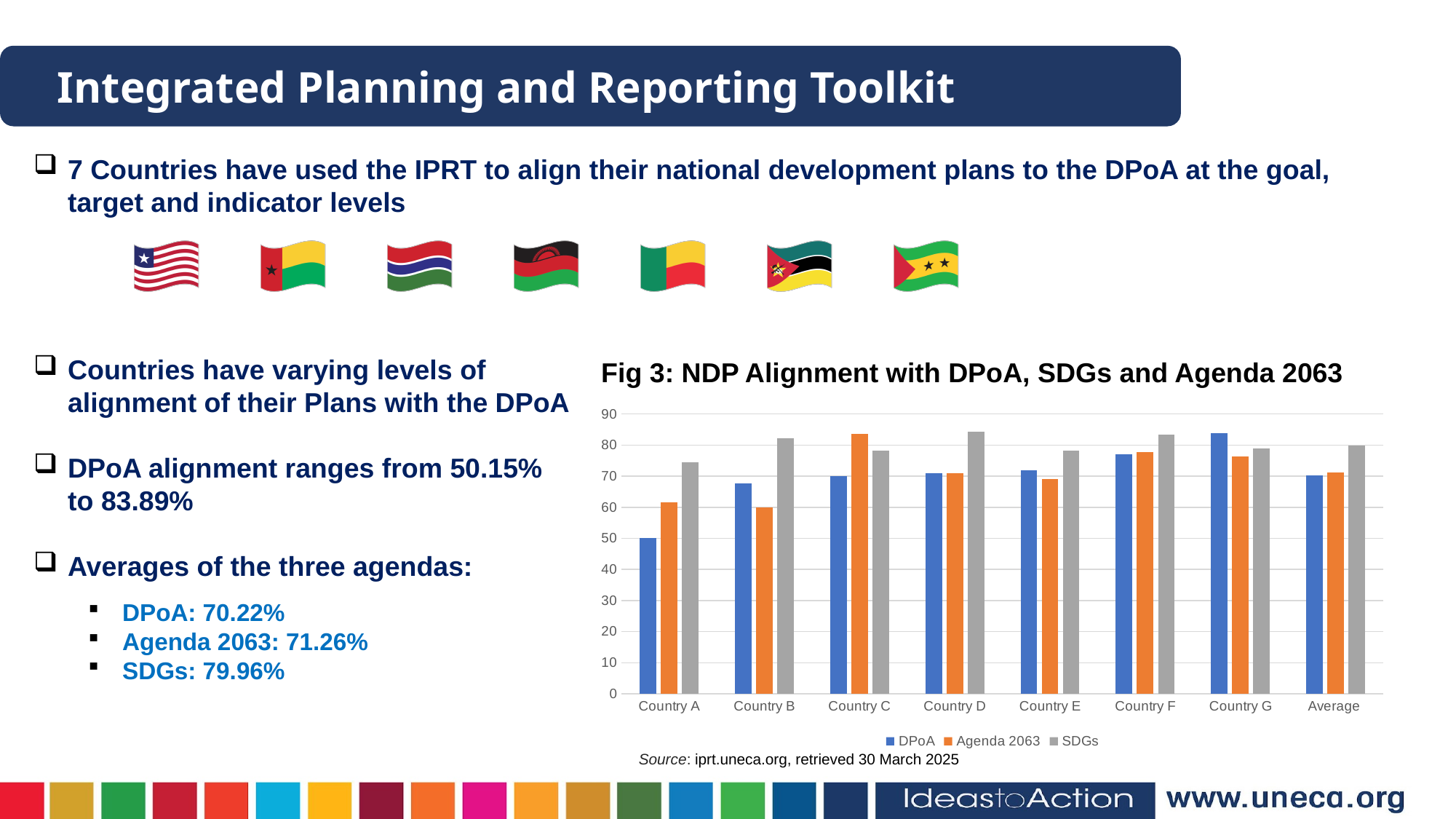
Is the SDGs value for Country D greater or less than 80? greater What kind of chart is Fig 3? Bar chart For Country A, which is larger: the DPoA value or the SDGs value? SDGs Is the DPoA value for Country A greater or less than 60? less For Country G, which is larger: the DPoA value or the SDGs value? DPoA What is the title of the chart on the slide? Fig 3: NDP Alignment with DPoA, SDGs and Agenda 2063 Is the Agenda 2063 value for Country C greater or less than 80? greater How many series does the legend of Fig 3 list? 3 Which country has the highest Agenda 2063 value in Fig 3? Country C Which country has the highest DPoA value in Fig 3? Country G How many categories are shown on the x axis of Fig 3? 8 Which country has the lowest DPoA value in Fig 3? Country A